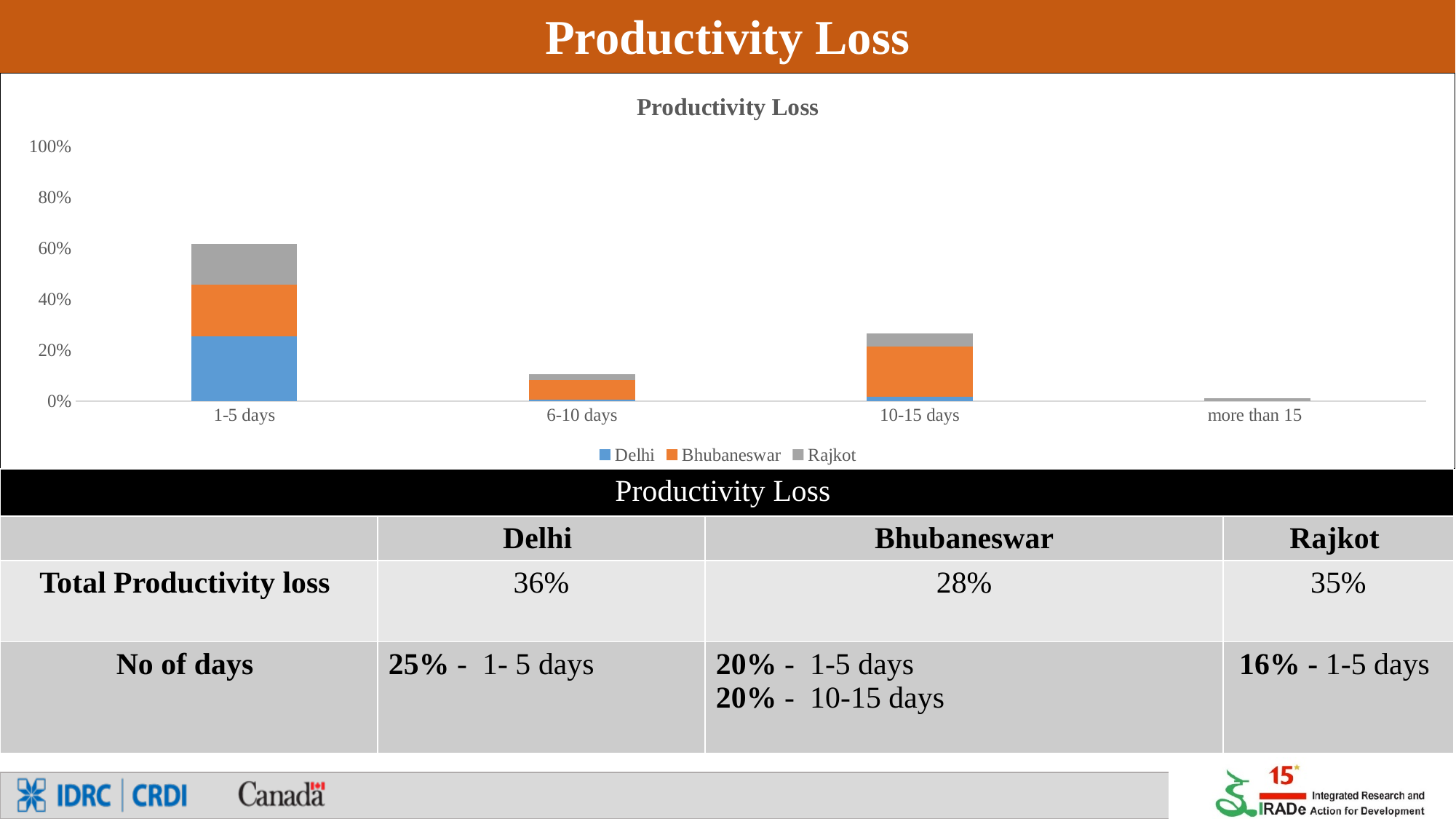
What kind of chart is shown on the slide? bar chart Which category has the shortest stacked bar? more than 15 Is the total height of the stacked bar for 10-15 days greater or less than 20%? greater How many categories are shown on the x axis of the chart? 4 Which colour represents Bhubaneswar in the chart? orange Is the total height of the stacked bar for 1-5 days greater or less than 40%? greater What is the title of the chart? Productivity Loss How many series does the chart's legend list? 3 Which stacked bar is taller, 1-5 days or 10-15 days? 1-5 days Is the value for Delhi in the 1-5 days category greater or less than 20%? greater Which category has the tallest stacked bar? 1-5 days